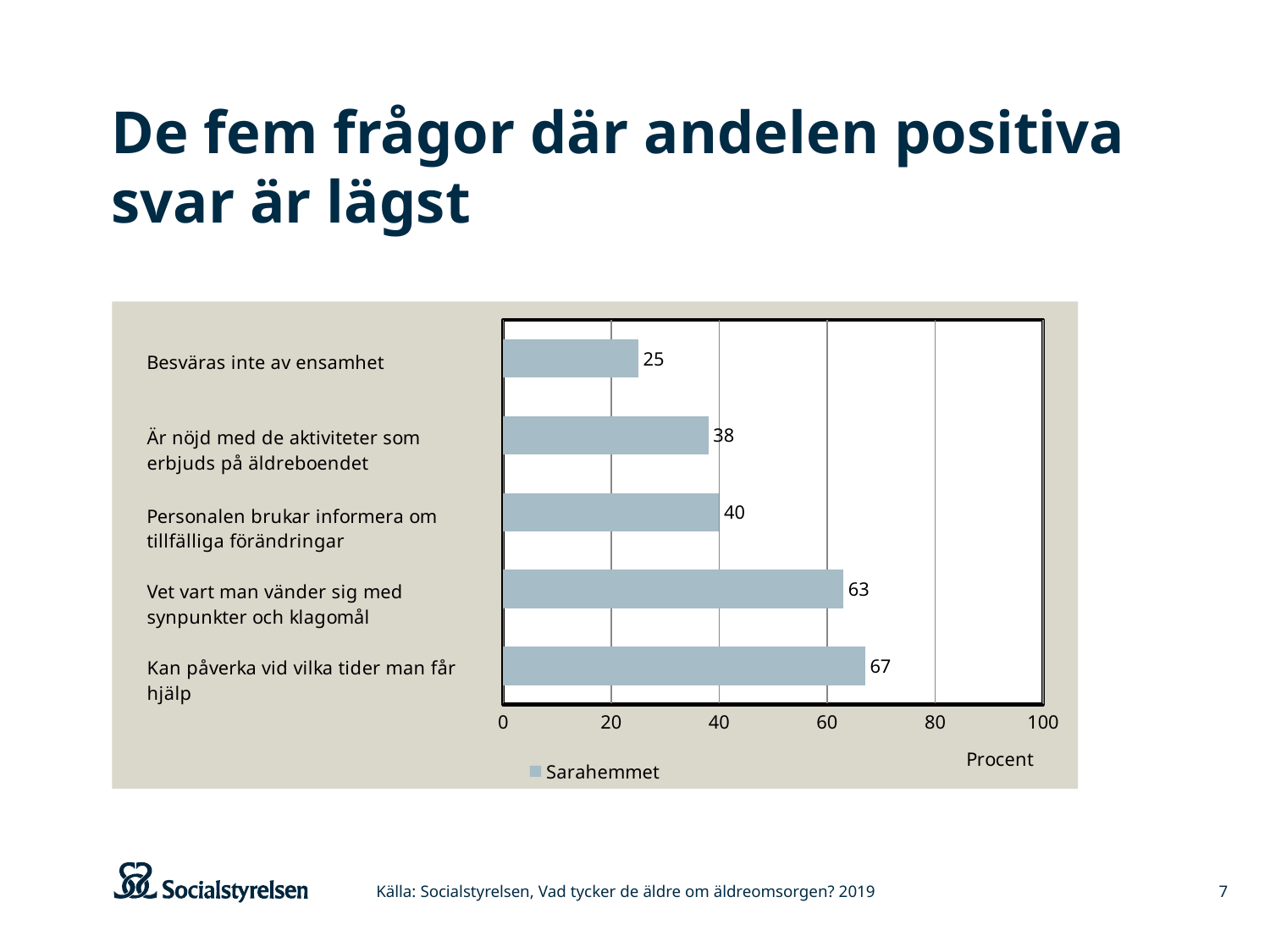
Which is larger: the value for "Är nöjd med de aktiviteter som erbjuds på äldreboendet" or the value for "Personalen brukar informera om tillfälliga förändringar"? Personalen brukar informera om tillfälliga förändringar Is the value for "Vet vart man vänder sig med synpunkter och klagomål" greater or less than 60? greater What is the value for "Kan påverka vid vilka tider man får hjälp"? 67 How many series does the legend list? 1 What is the value for "Personalen brukar informera om tillfälliga förändringar"? 40 How many categories are shown in the chart? 5 What is the name of the series shown in the legend? Sarahemmet What is the value for "Besväras inte av ensamhet"? 25 Which category has the highest value? Kan påverka vid vilka tider man får hjälp What kind of chart is shown on the slide? bar chart What is the difference between the values for "Vet vart man vänder sig med synpunkter och klagomål" and "Är nöjd med de aktiviteter som erbjuds på äldreboendet"? 25 Which category has the lowest value? Besväras inte av ensamhet